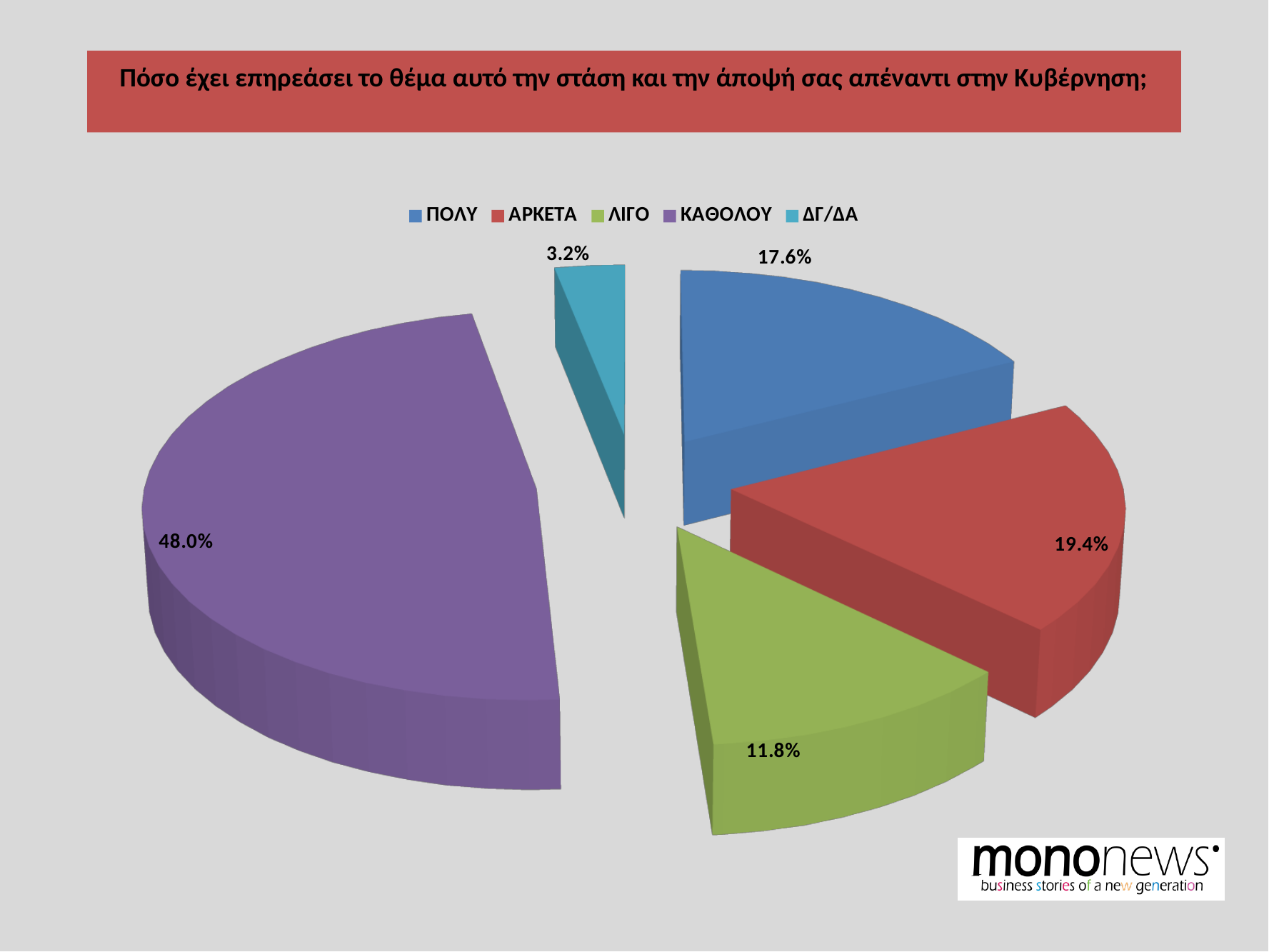
What kind of chart is shown on the slide? Pie chart Which colour represents ΚΑΘΟΛΟΥ in the legend? Purple What is the value for ΛΙΓΟ? 11.8% What is the value for ΑΡΚΕΤΑ? 19.4% What is the value for ΠΟΛΥ? 17.6% What is the value for ΚΑΘΟΛΟΥ? 48.0% What is the difference between the values for ΑΡΚΕΤΑ and ΠΟΛΥ? 1.8% Which category has the largest share of the pie? ΚΑΘΟΛΟΥ How many categories does the pie chart have? 5 Which is larger, the value for ΛΙΓΟ or the value for ΠΟΛΥ? ΠΟΛΥ What is the value for ΔΓ/ΔΑ? 3.2% Which category has the smallest share of the pie? ΔΓ/ΔΑ